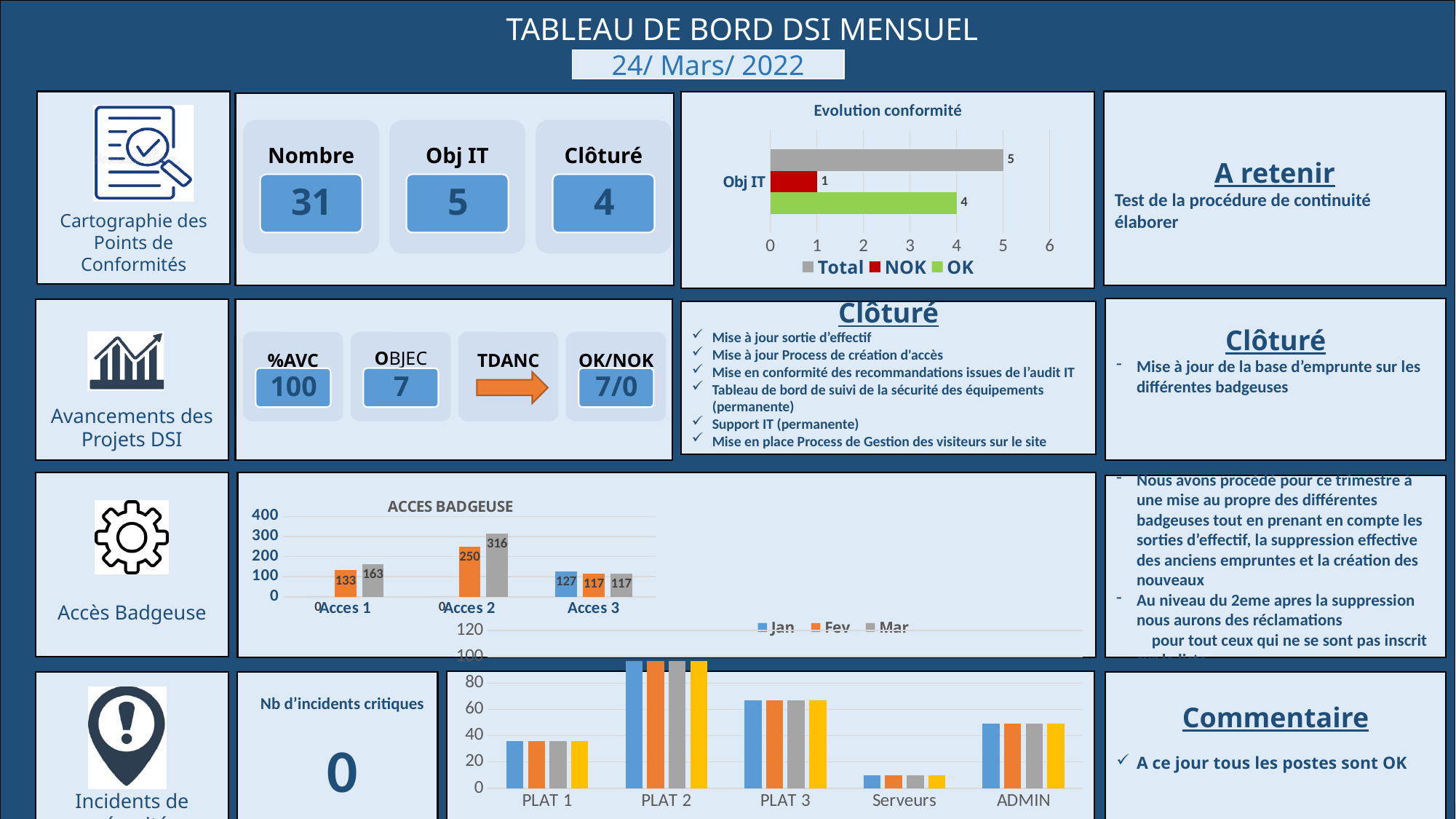
In the 'ACCES BADGEUSE' chart, is the Jan value for Acces 3 larger or smaller than the Fev value for Acces 3? Larger In the 'Evolution conformité' chart, what is the difference between the OK value and the NOK value? 3 In the 'ACCES BADGEUSE' chart, what is the Mar value for Acces 2? 316 How many categories are shown on the x axis of the bottom chart (PLAT 1 to ADMIN)? 5 How many series does the legend of the 'Evolution conformité' chart list? 3 In the 'ACCES BADGEUSE' chart, what is the Fev value for Acces 1? 133 In the 'ACCES BADGEUSE' chart, which category has the highest Mar value? Acces 2 In the 'ACCES BADGEUSE' chart, what is the difference between the Mar and Fev values for Acces 2? 66 In the 'Evolution conformité' chart, what is the value of the Total series for Obj IT? 5 In the bottom chart, is the value for Serveurs greater or less than 20? less What kind of chart is 'Evolution conformité'? Bar chart In the 'Evolution conformité' chart, what is the value of the NOK series? 1